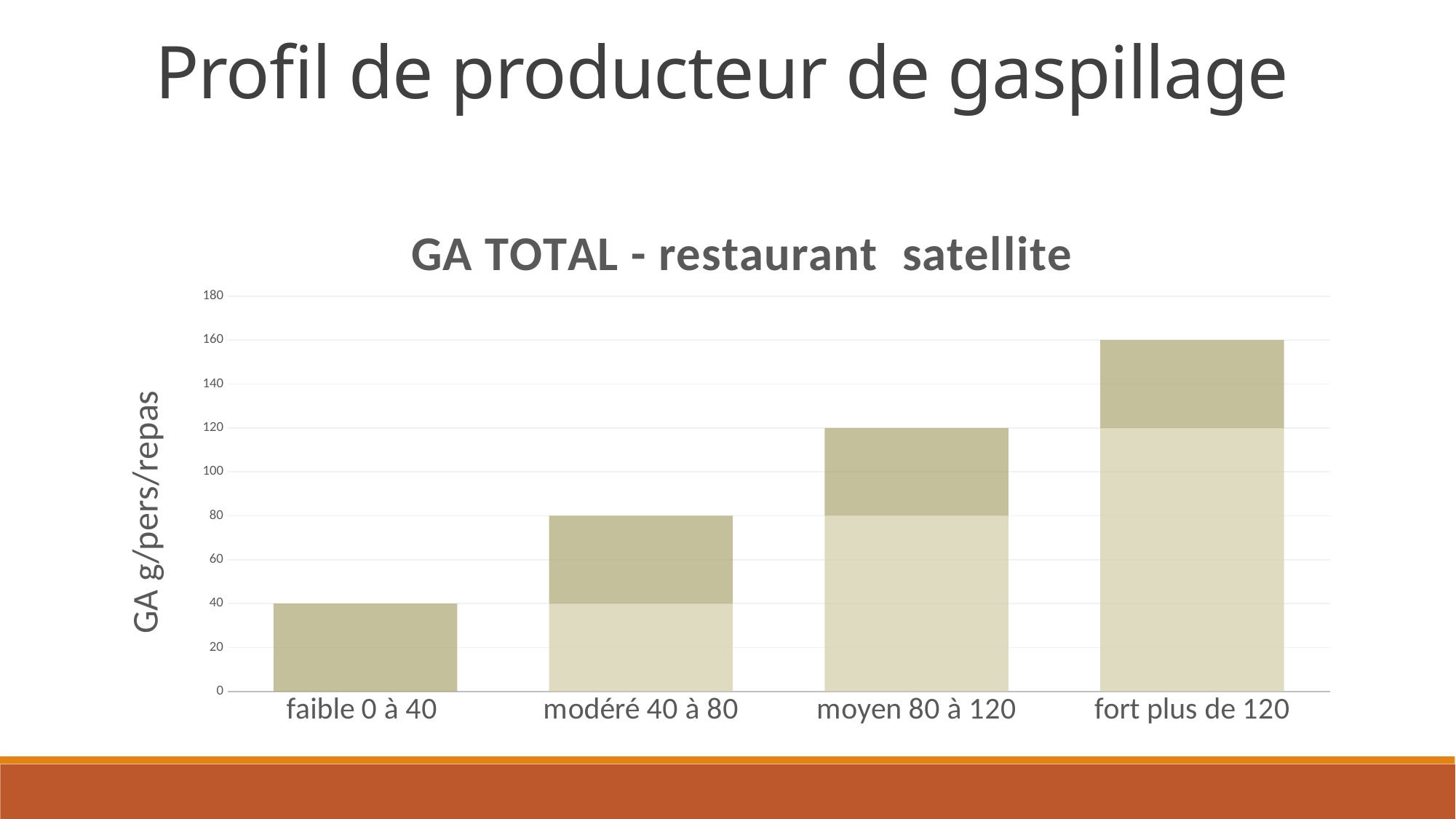
What is the total height of the bar for 'fort plus de 120'? 160 What is the total height of the bar for 'faible 0 à 40'? 40 What is the total height of the bar for 'moyen 80 à 120'? 120 Which category has the lowest bar? faible 0 à 40 Which is larger, the bar for 'moyen 80 à 120' or the bar for 'modéré 40 à 80'? moyen 80 à 120 Which category has the highest bar? fort plus de 120 What is the title of the chart? GA TOTAL - restaurant satellite How many categories are shown on the x axis of the chart? 4 Do the bar heights rise or fall from left to right along the x axis? rise What is the difference between the bar for 'fort plus de 120' and the bar for 'faible 0 à 40'? 120 What is the total height of the bar for 'modéré 40 à 80'? 80 What kind of chart is shown on the slide? bar chart